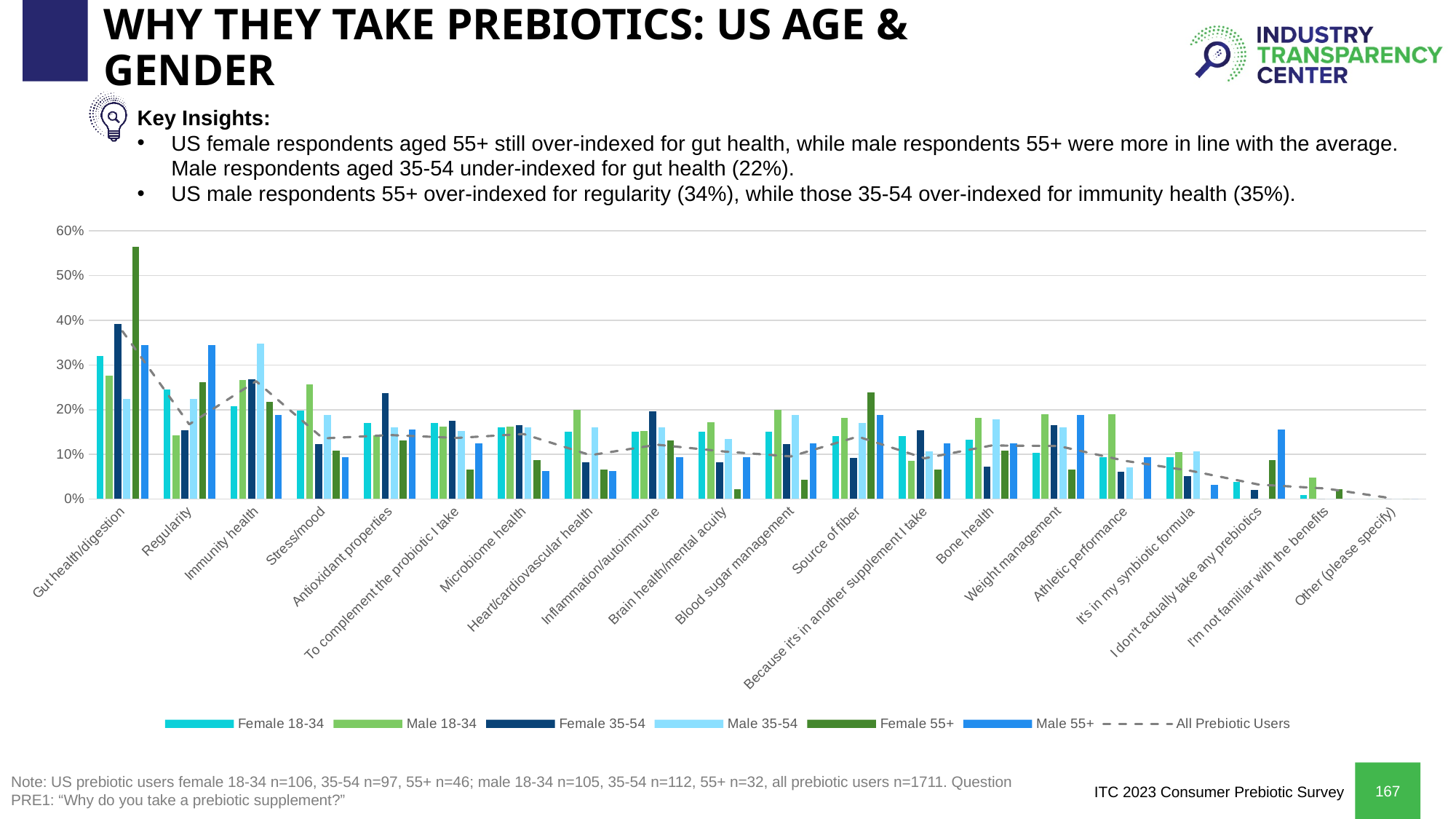
How many categories (reasons) are shown along the x axis of the chart? 20 Which legend entry is drawn as a dashed line rather than a bar? All Prebiotic Users Is the Female 55+ value for Gut health/digestion greater or less than 50%? greater Is the Female 55+ value for Brain health/mental acuity greater or less than 10%? less Does the dashed All Prebiotic Users line generally rise or fall from left to right across the categories? fall For Immunity health, which is larger: the Male 35-54 value or the Female 18-34 value? Male 35-54 Which series has the highest value for Gut health/digestion? Female 55+ For Regularity, which is larger: the Male 55+ value or the Female 18-34 value? Male 55+ Is the Male 35-54 value for Immunity health greater or less than 30%? greater How many entries does the chart legend list? 7 Which category has the tallest bar in the chart? Gut health/digestion What kind of chart is shown on the slide? combination bar and line chart